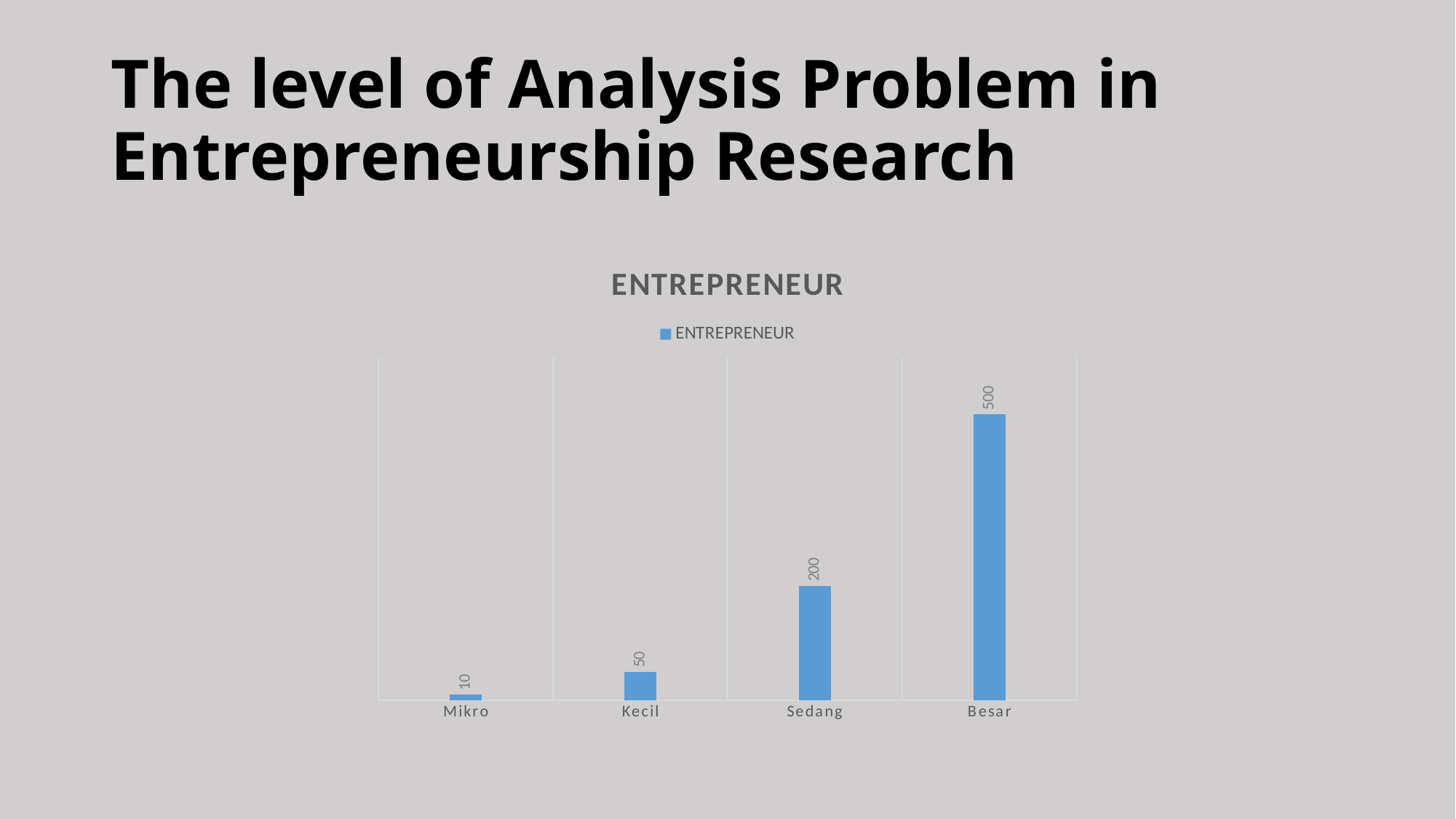
Which category has the lowest value? Mikro What is the value for Besar? 500 What is the value for Sedang? 200 Which is larger, the value for Sedang or the value for Kecil? Sedang What is the value for Kecil? 50 How many categories are shown on the x axis? 4 What is the value for Mikro? 10 Which category has the highest value? Besar What is the difference between the values for Kecil and Mikro? 40 Do the values rise or fall from Mikro to Besar along the x axis? Rise What is the difference between the values for Besar and Sedang? 300 What kind of chart is shown on the slide? Bar chart